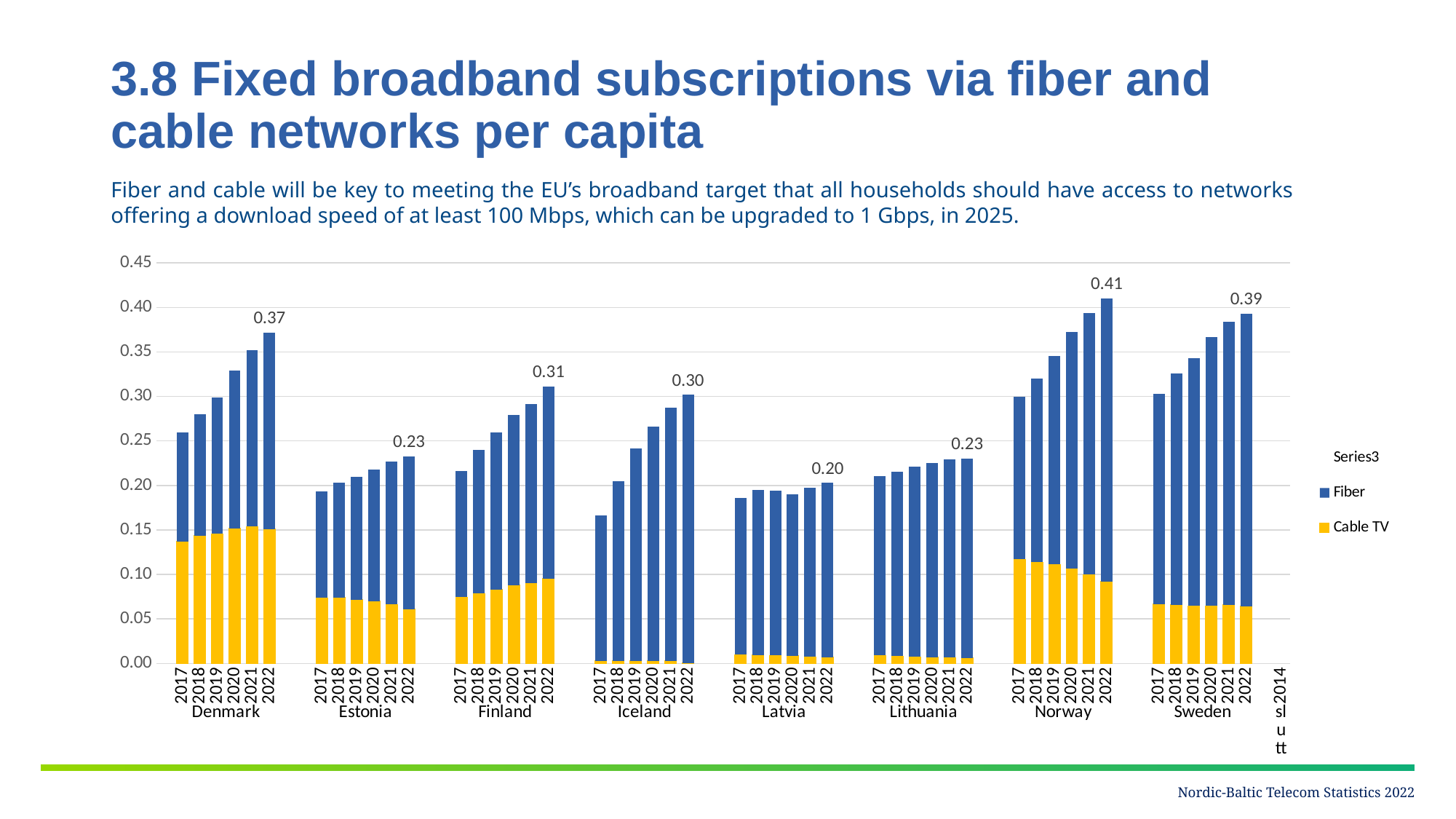
Is the total value for Denmark in 2017 greater or less than 0.30? less Which is larger, the 2022 value for Finland or the 2022 value for Iceland? Finland What is the difference between the 2022 values for Norway and Sweden? 0.02 How many countries are shown on the x axis with data bars? 8 Which country has the highest labelled 2022 value? Norway Is the total value for Norway in 2019 greater or less than 0.30? greater What kind of chart is shown on the slide? Stacked bar chart What is the labelled 2022 value for Latvia? 0.20 Which country has the lowest labelled 2022 value? Latvia What is the total fixed broadband subscriptions per capita via fiber and cable for Norway in 2022? 0.41 What is the labelled 2022 value for Denmark? 0.37 Do the total values for Norway rise or fall from 2017 to 2022? Rise